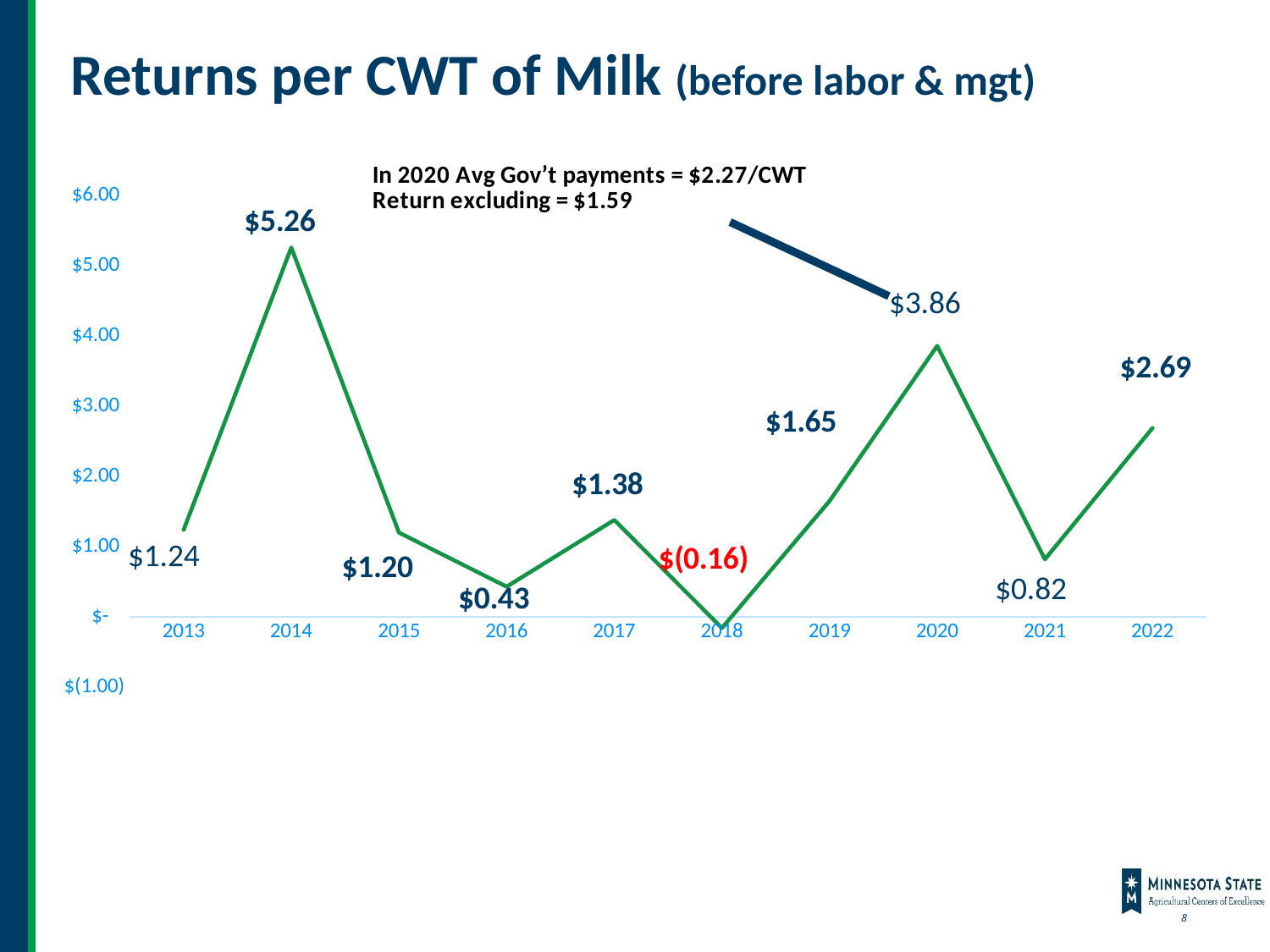
Is the value for 2020 greater or less than $3.00? greater What kind of chart is shown on the slide? line chart According to the annotation, what was the 2020 return excluding government payments? $1.59 Which year has a higher return per CWT of milk, 2019 or 2017? 2019 What is the difference between the return per CWT in 2020 and in 2021? $3.04 What is the return per CWT of milk in 2018? $(0.16) Which year has the highest return per CWT of milk? 2014 What is the return per CWT of milk in 2022? $2.69 Which year has the lowest return per CWT of milk? 2018 How many years are plotted on the chart? 10 What is the return per CWT of milk in 2016? $0.43 What is the return per CWT of milk in 2014? $5.26